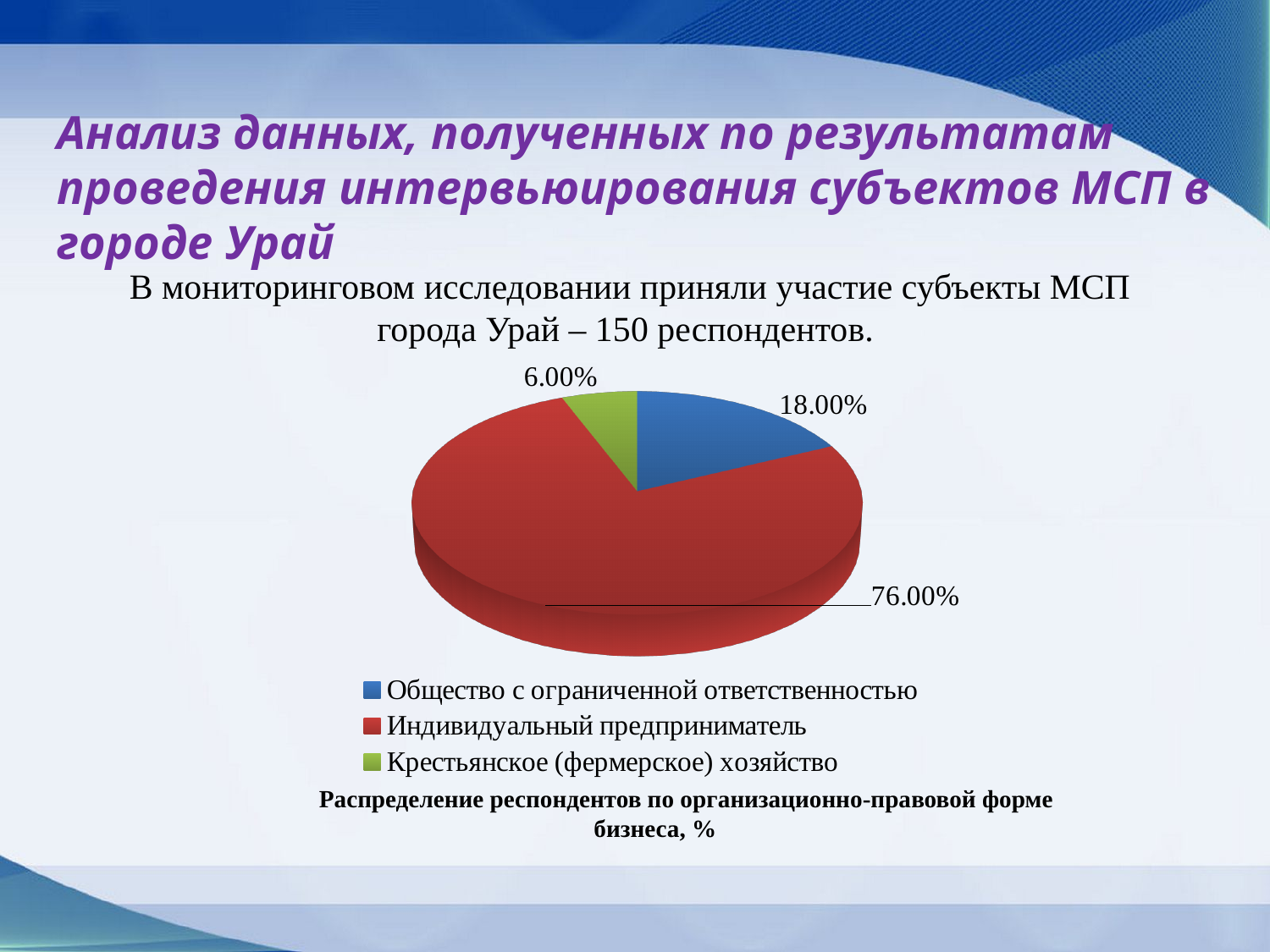
Which category has the largest share of the pie? Индивидуальный предприниматель Which is larger: the share for "Общество с ограниченной ответственностью" or for "Крестьянское (фермерское) хозяйство"? Общество с ограниченной ответственностью Which category has the smallest share of the pie? Крестьянское (фермерское) хозяйство What is the difference in percentage points between "Общество с ограниченной ответственностью" and "Крестьянское (фермерское) хозяйство"? 12.00% What share of respondents are "Крестьянское (фермерское) хозяйство"? 6.00% What is the difference in percentage points between "Индивидуальный предприниматель" and "Общество с ограниченной ответственностью"? 58.00% What kind of chart is shown on the slide? pie chart Which colour represents "Индивидуальный предприниматель" in the legend? red What is the title of the chart? Распределение респондентов по организационно-правовой форме бизнеса, % What share of respondents are "Индивидуальный предприниматель"? 76.00% What share of respondents are "Общество с ограниченной ответственностью"? 18.00% How many categories does the pie chart have? 3